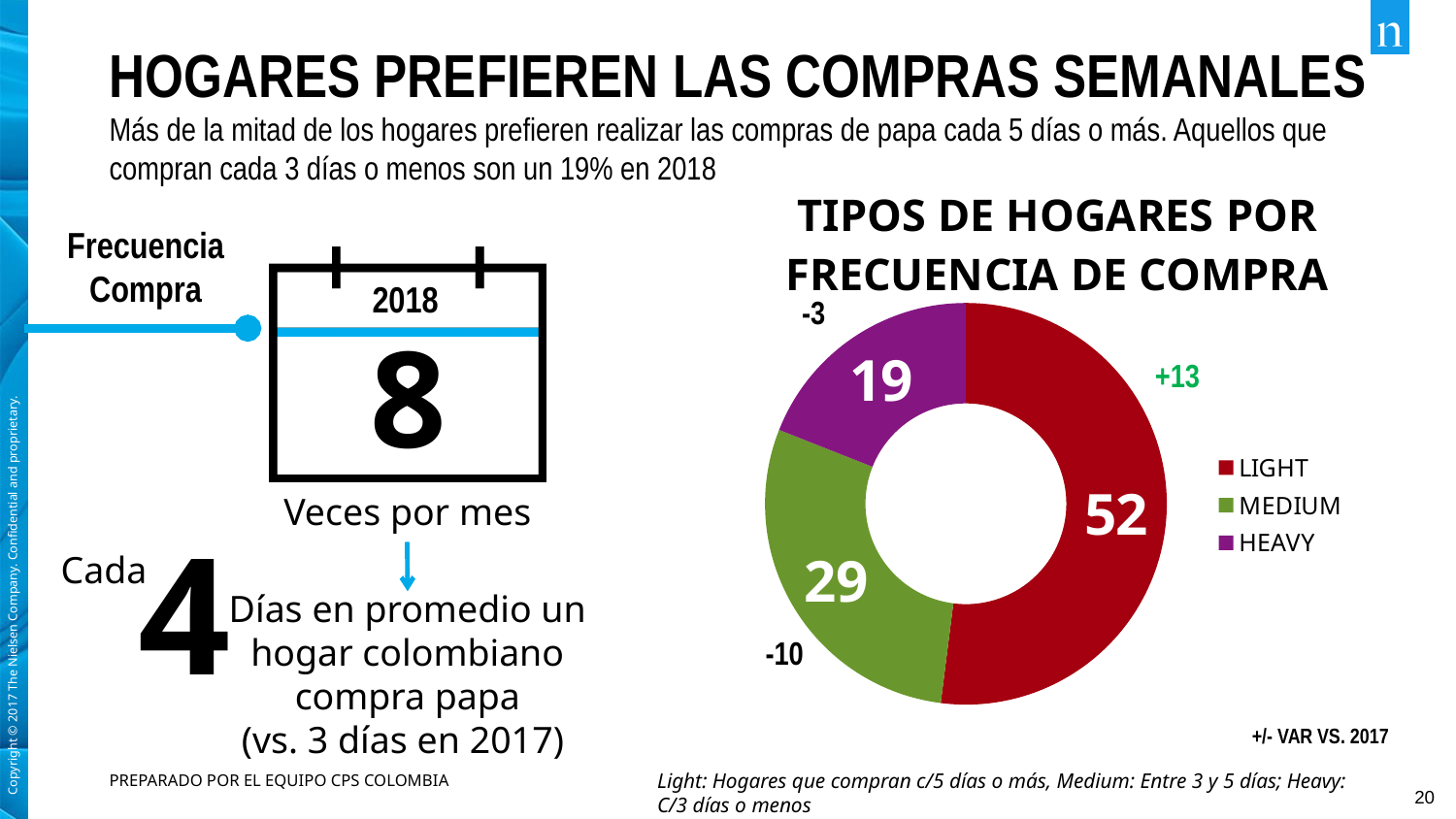
What colour represents HEAVY in the "TIPOS DE HOGARES POR FRECUENCIA DE COMPRA" chart? Purple What is the value for LIGHT in the "TIPOS DE HOGARES POR FRECUENCIA DE COMPRA" chart? 52 In the "TIPOS DE HOGARES POR FRECUENCIA DE COMPRA" chart, what is the variation vs. 2017 shown next to the LIGHT slice? +13 In the "TIPOS DE HOGARES POR FRECUENCIA DE COMPRA" chart, what is the variation vs. 2017 shown next to the MEDIUM slice? -10 In the "TIPOS DE HOGARES POR FRECUENCIA DE COMPRA" chart, what is the difference between the LIGHT and MEDIUM values? 23 Which category has the largest slice in the "TIPOS DE HOGARES POR FRECUENCIA DE COMPRA" chart? LIGHT What type of chart is shown under the title "TIPOS DE HOGARES POR FRECUENCIA DE COMPRA"? Pie (donut) chart Which category has the smallest slice in the "TIPOS DE HOGARES POR FRECUENCIA DE COMPRA" chart? HEAVY What is the value for HEAVY in the "TIPOS DE HOGARES POR FRECUENCIA DE COMPRA" chart? 19 In the "TIPOS DE HOGARES POR FRECUENCIA DE COMPRA" chart, which is larger, MEDIUM or HEAVY? MEDIUM What is the value for MEDIUM in the "TIPOS DE HOGARES POR FRECUENCIA DE COMPRA" chart? 29 How many categories does the legend of the "TIPOS DE HOGARES POR FRECUENCIA DE COMPRA" chart list? 3